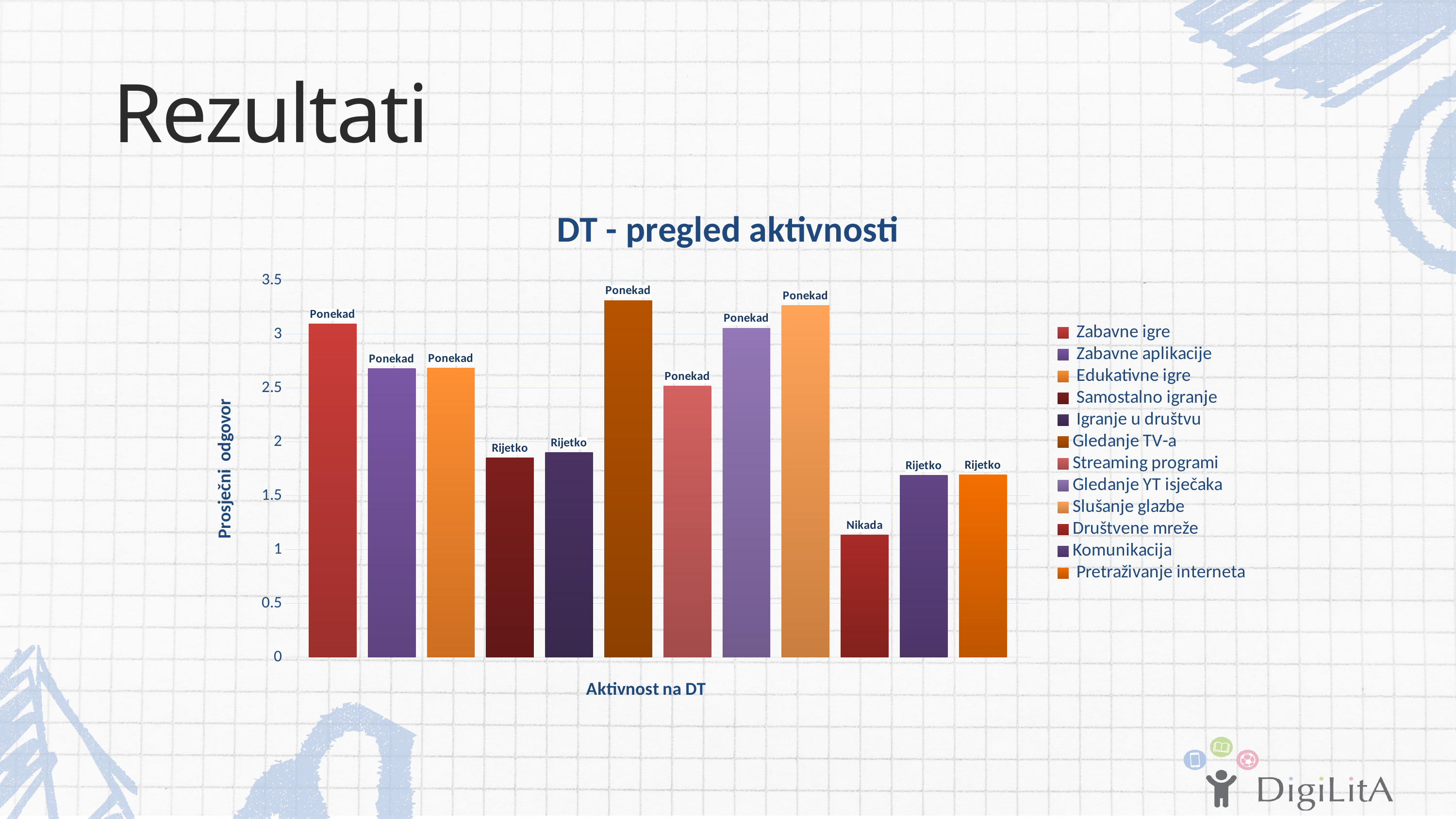
What is the label of the vertical axis? Prosječni odgovor What type of chart is shown on the slide? bar chart Is the value for Zabavne igre greater or less than 3? greater What data label is printed above the bar for Društvene mreže? Nikada How many bars are plotted in the chart? 12 What data label is printed above the bar for Komunikacija? Rijetko Which activity has the lowest bar in the chart? Društvene mreže What is the title of the chart? DT - pregled aktivnosti Is the value for Samostalno igranje greater or less than 2? less Which is larger, the value for Zabavne igre or the value for Zabavne aplikacije? Zabavne igre How many series does the chart legend list? 12 What data label is printed above the bar for Gledanje TV-a? Ponekad